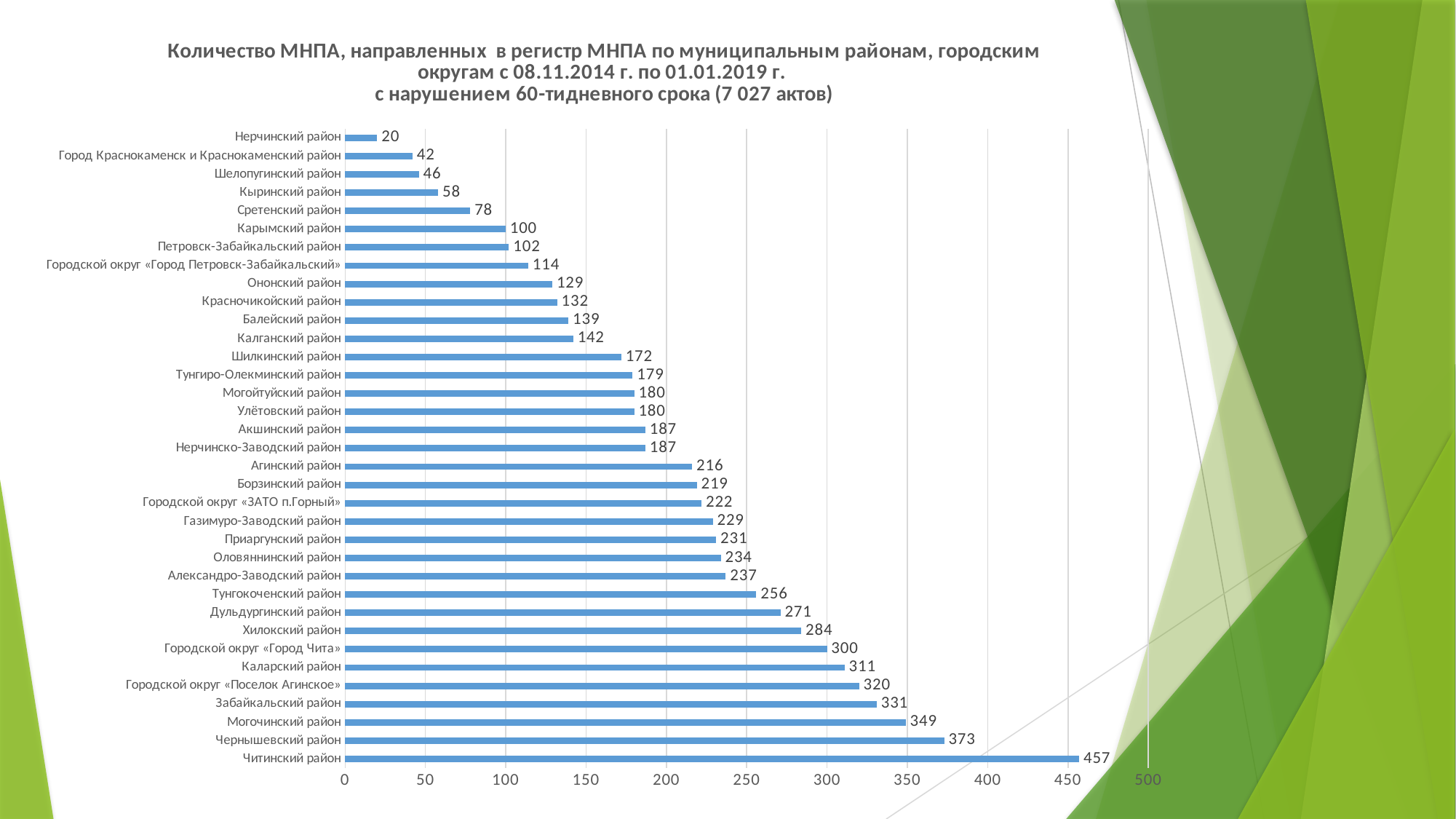
What is the difference between the values for Читинский район and Чернышевский район? 84 What total number of acts is stated in the chart title? 7 027 What is the difference between the values for Хилокский район and Кыринский район? 226 Which is larger, the value for Могочинский район or the value for Забайкальский район? Могочинский район Which category has the lowest value? Нерчинский район What is the value for Читинский район? 457 What is the value for Городской округ «Город Чита»? 300 Is the value for Каларский район greater or less than 300? greater Which category has the highest value? Читинский район What is the value for Сретенский район? 78 What kind of chart is shown on the slide? bar chart How many categories are shown in the chart? 35